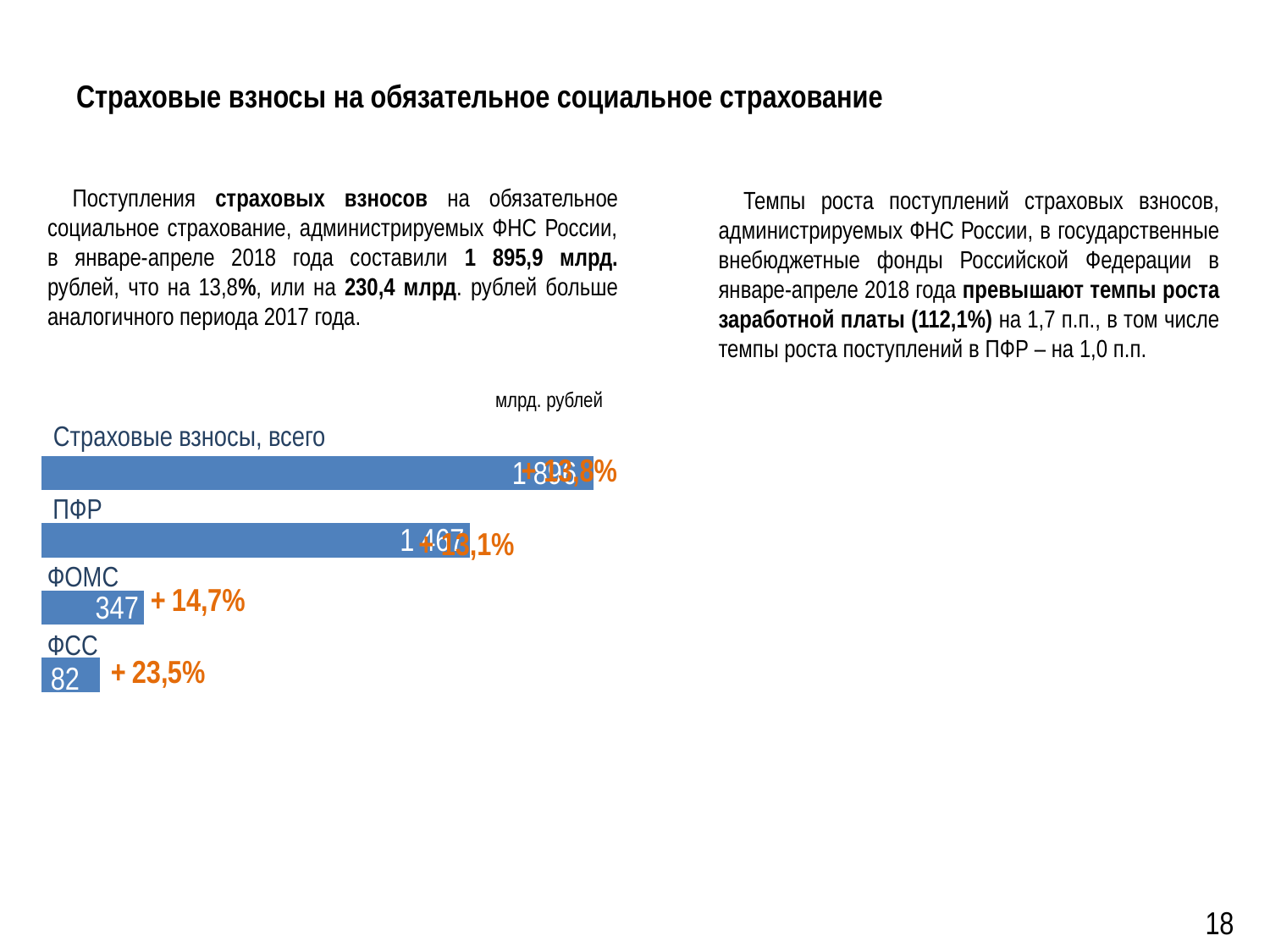
Which category has the shortest bar in the chart? ФСС Which bar is longer, ФОМС or ФСС? ФОМС How many categories are plotted in the bar chart? 4 Which category has the longest bar in the chart? Страховые взносы, всего What growth percentage is shown next to the ФОМС bar? + 14,7% What growth percentage is shown next to the ФСС bar? + 23,5% What is the value shown for ФСС in the bar chart? 82 What is the difference between the values for ФОМС and ФСС? 265 What unit is indicated above the bar chart? млрд. рублей Which bar is longer, ПФР or ФОМС? ПФР What is the value shown for ФОМС in the bar chart? 347 What kind of chart is shown on the slide? bar chart